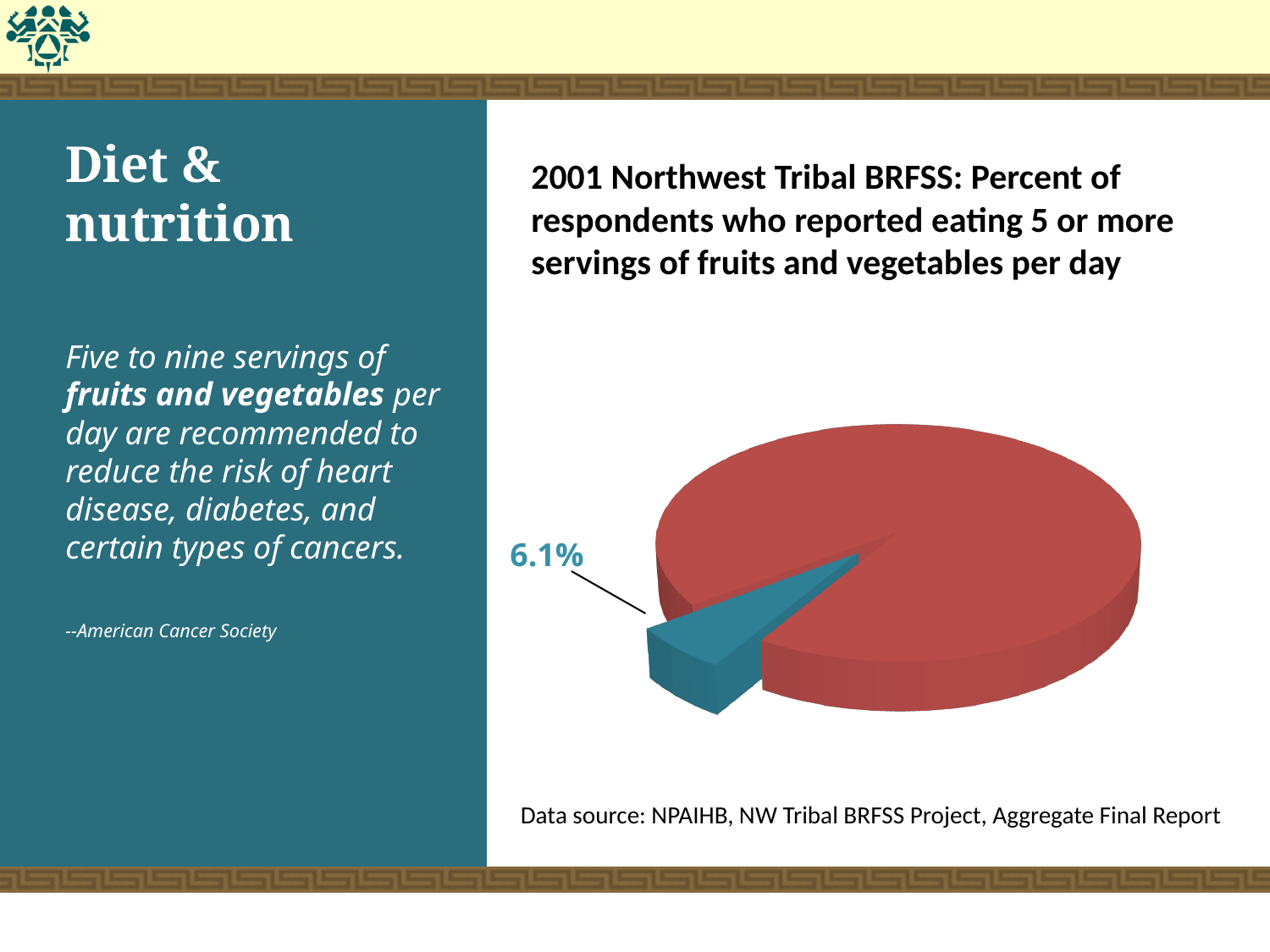
What share of the pie does the teal slice represent? 6.1% Which slice of the pie chart is the smallest? the teal slice (6.1%) Which slice of the pie chart is larger, the red slice or the teal slice? red What percentage is printed on the small teal slice of the pie chart? 6.1% How many slices does the pie chart have? 2 What data source is cited below the chart? NPAIHB, NW Tribal BRFSS Project, Aggregate Final Report What kind of chart is shown on the slide? pie chart Which slice of the pie chart is the largest? the red slice What is the title of the chart? 2001 Northwest Tribal BRFSS: Percent of respondents who reported eating 5 or more servings of fruits and vegetables per day